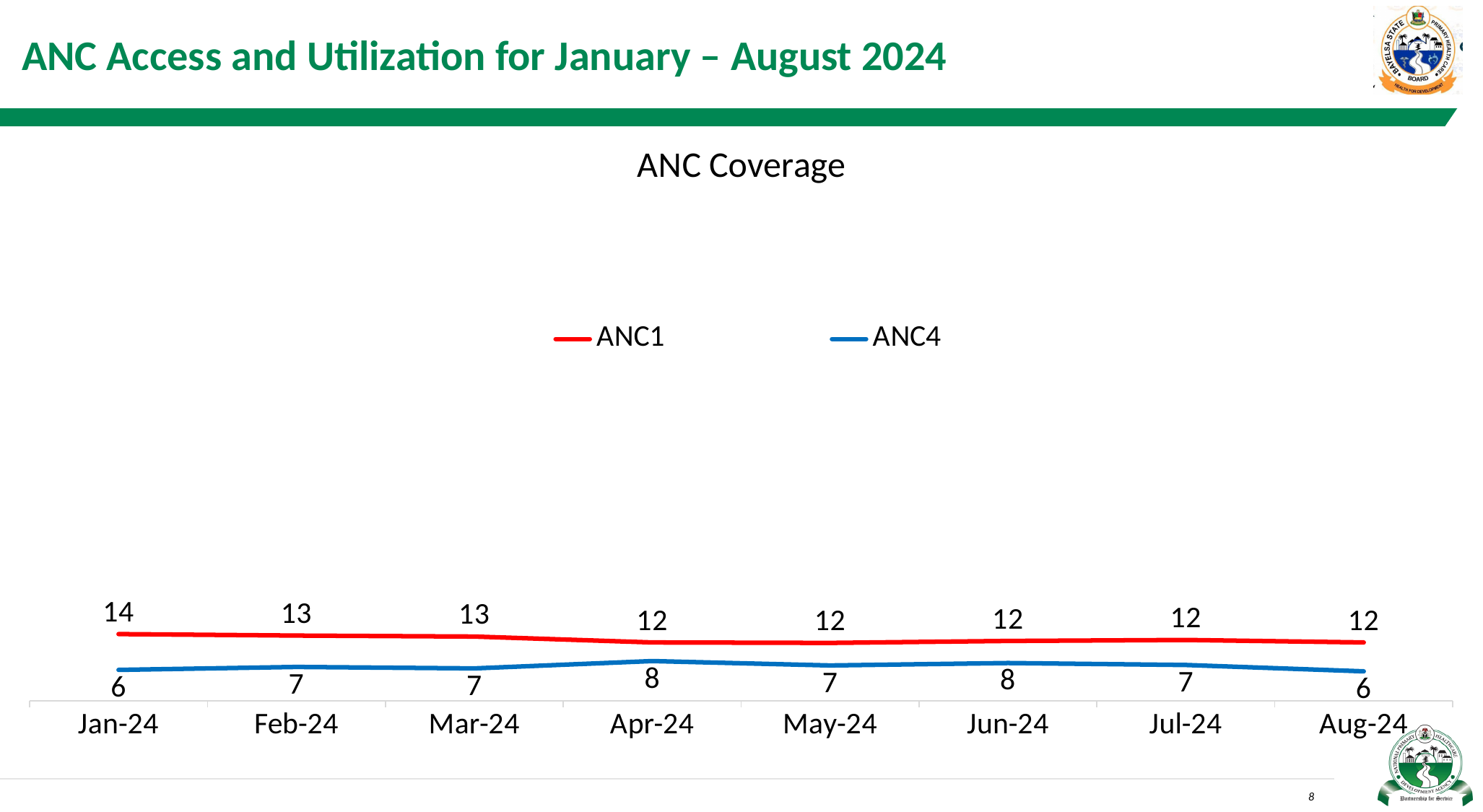
What is the difference between ANC1 and ANC4 in Jan-24? 8 How many months are shown on the x axis? 8 What is the title of the chart? ANC Coverage What is the ANC1 value for Aug-24? 12 What is the ANC4 value for Jul-24? 7 What is the ANC1 value for Jan-24? 14 In which month is ANC1 highest? Jan-24 How many series does the legend list? 2 Which is larger in Mar-24, ANC1 or ANC4? ANC1 What kind of chart is shown? Line chart What is the difference between ANC1 and ANC4 in Apr-24? 4 What is the ANC4 value for Apr-24? 8